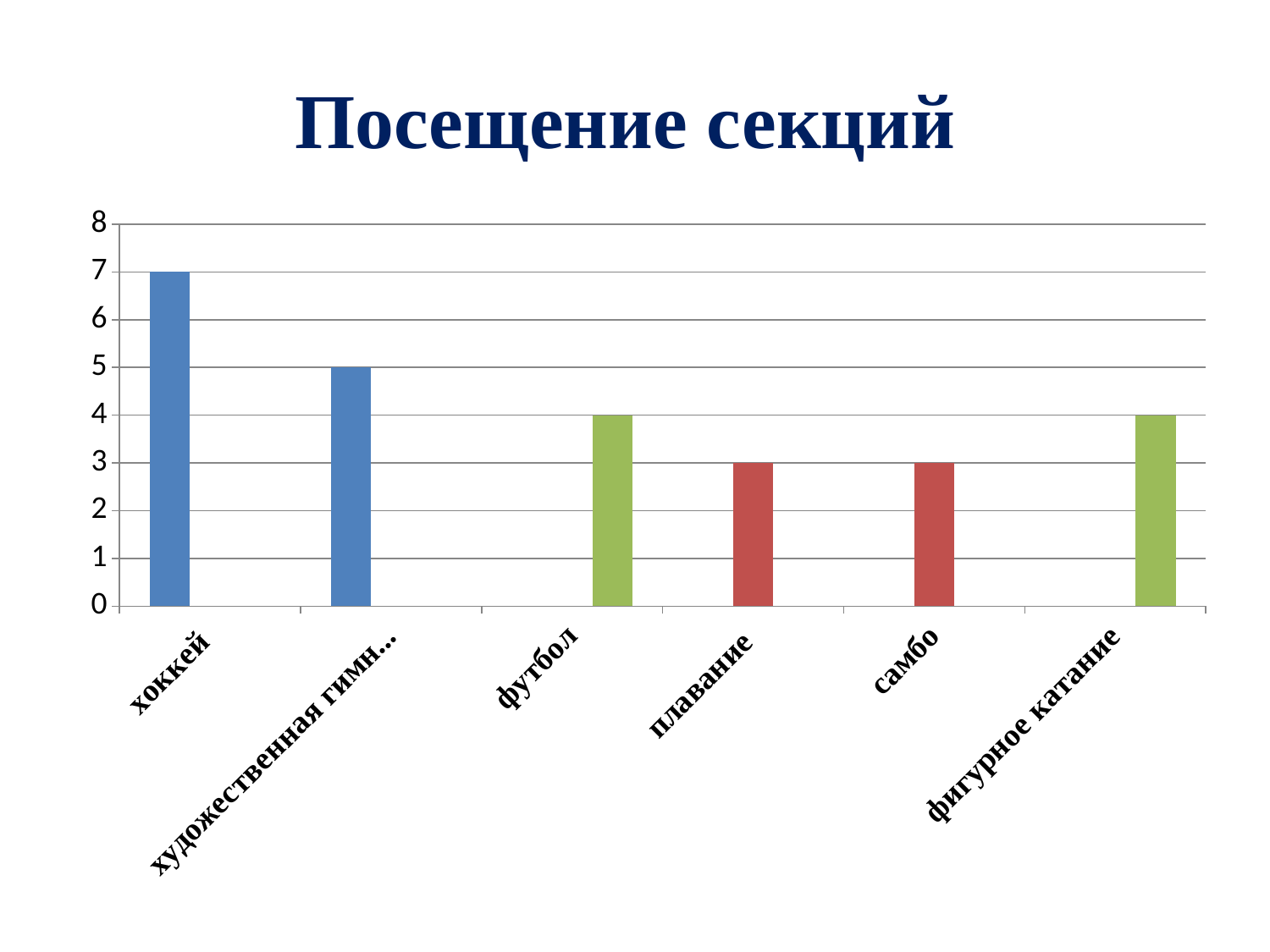
What is the value for хоккей? 7 Is the value for хоккей greater or less than 6? greater What is the value for фигурное катание? 4 What is the value of the second bar from the left? 5 What is the value for футбол? 4 What type of chart is shown on the slide? bar chart How many categories are shown on the x axis? 6 Which is larger, the value for футбол or the value for самбо? футбол What is the difference between the values for хоккей and самбо? 4 What is the value for плавание? 3 What is the title of the chart? Посещение секций Which category has the highest value? хоккей